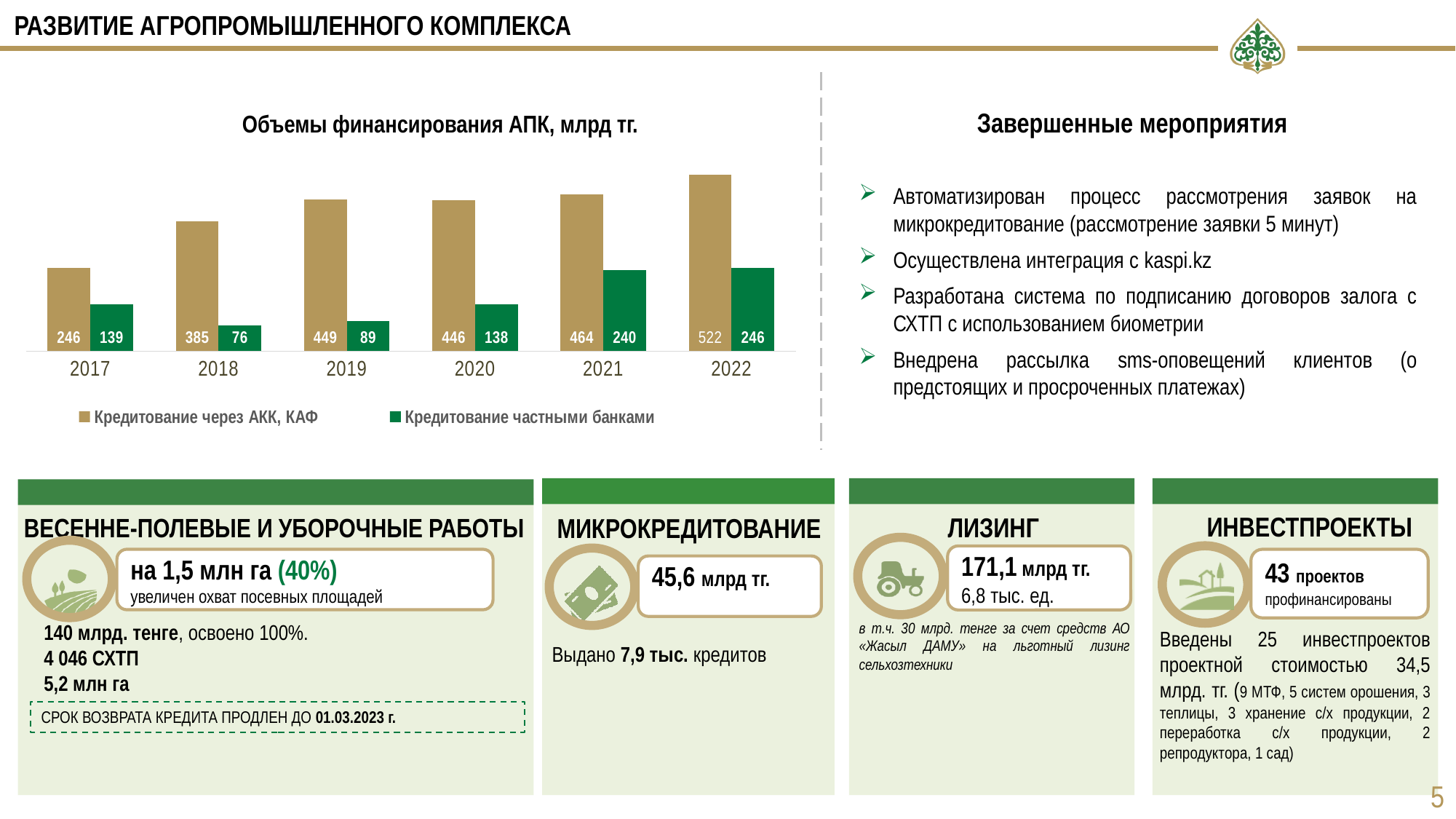
In which year is 'Кредитование через АКК, КАФ' highest? 2022 What is the value for 'Кредитование частными банками' in 2021? 240 Which is larger in 2020: 'Кредитование через АКК, КАФ' or 'Кредитование частными банками'? Кредитование через АКК, КАФ What is the value for 'Кредитование частными банками' in 2018? 76 How many years are shown on the x axis of the chart? 6 What is the title of the chart on the slide? Объемы финансирования АПК, млрд тг. Does 'Кредитование через АКК, КАФ' rise or fall from 2017 to 2018? Rise What kind of chart is 'Объемы финансирования АПК, млрд тг.'? Bar chart In which year is 'Кредитование частными банками' lowest? 2018 What is the value for 'Кредитование через АКК, КАФ' in 2022? 522 What is the difference between 'Кредитование через АКК, КАФ' and 'Кредитование частными банками' in 2019? 360 How many series does the chart legend list? 2